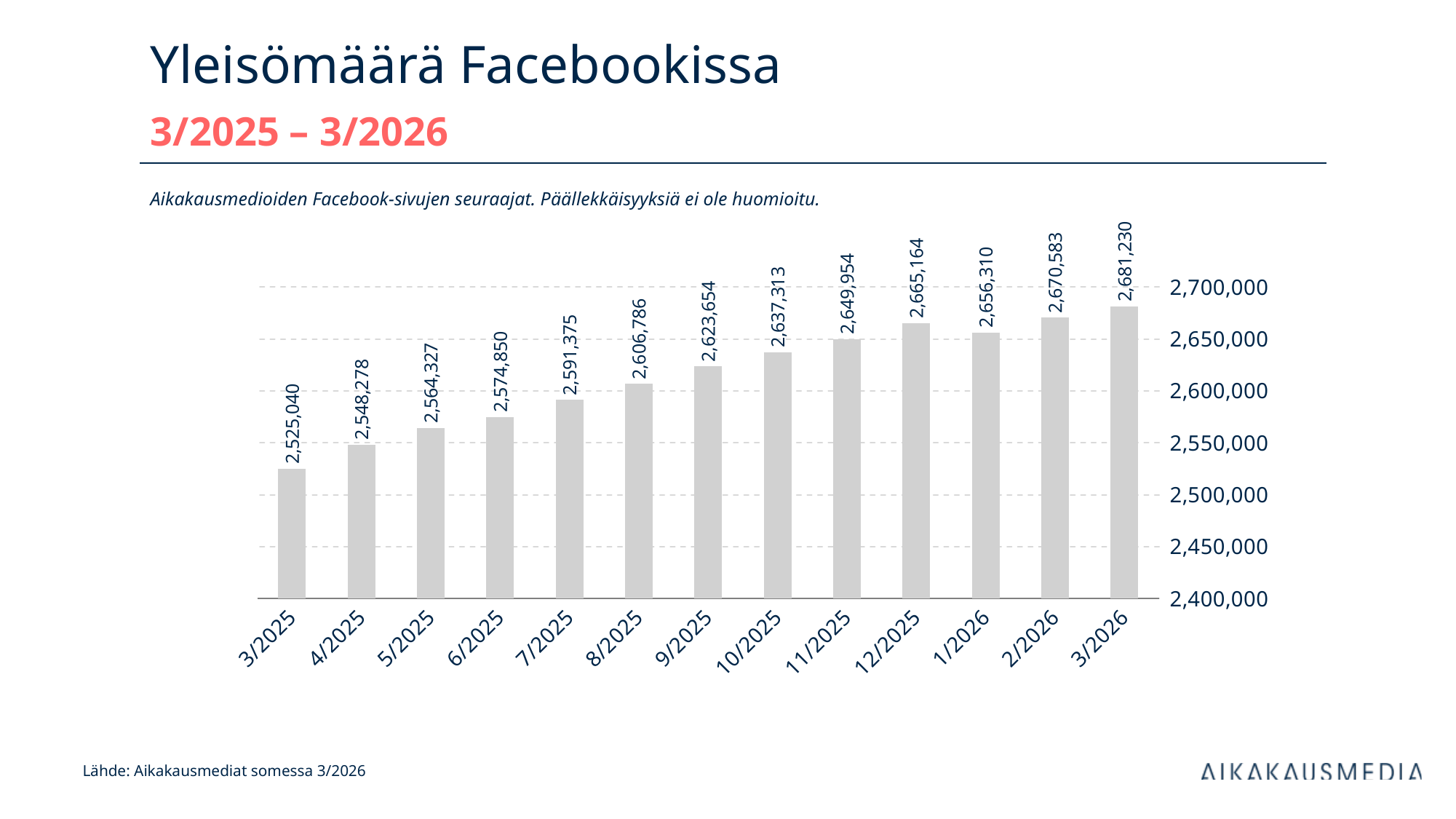
Is the value for 8/2025 greater or less than 2,600,000? greater Do the values generally rise or fall from 3/2025 to 3/2026? rise What is the value for 10/2025? 2,637,313 What is the value for 3/2025? 2,525,040 Which month has the highest value? 3/2026 How many months are shown on the x axis? 13 What kind of chart is shown on the slide? bar chart Which is larger, the value for 12/2025 or the value for 1/2026? 12/2025 What is the difference between the values for 3/2026 and 3/2025? 156,190 What is the value for 1/2026? 2,656,310 What is the difference between the values for 12/2025 and 1/2026? 8,854 Which month has the lowest value? 3/2025